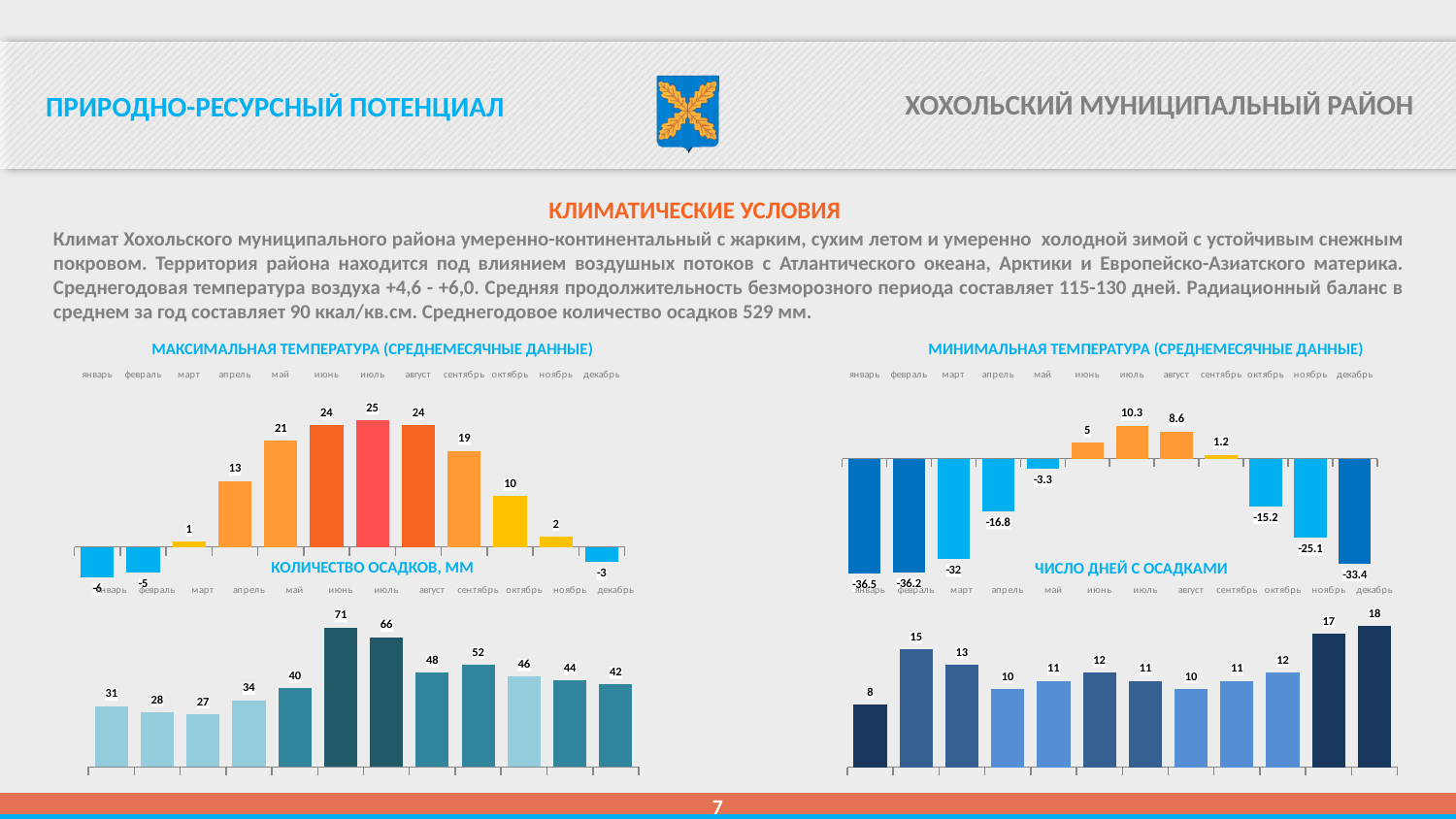
On the chart 'ЧИСЛО ДНЕЙ С ОСАДКАМИ', which is larger, the value for февраль or the value for март? февраль On the chart 'КОЛИЧЕСТВО ОСАДКОВ, ММ', which month has the lowest value? март On the chart 'КОЛИЧЕСТВО ОСАДКОВ, ММ', what is the difference between the values for июнь and июль? 5 What type of chart is 'КОЛИЧЕСТВО ОСАДКОВ, ММ'? bar chart How many months (categories) are shown on the chart 'МАКСИМАЛЬНАЯ ТЕМПЕРАТУРА (СРЕДНЕМЕСЯЧНЫЕ ДАННЫЕ)'? 12 On the chart 'ЧИСЛО ДНЕЙ С ОСАДКАМИ', what is the value for декабрь? 18 On the chart 'МИНИМАЛЬНАЯ ТЕМПЕРАТУРА (СРЕДНЕМЕСЯЧНЫЕ ДАННЫЕ)', what is the value for апрель? -16.8 On the chart 'ЧИСЛО ДНЕЙ С ОСАДКАМИ', which month has the lowest value? январь On the chart 'КОЛИЧЕСТВО ОСАДКОВ, ММ', what is the value for июнь? 71 On the chart 'МАКСИМАЛЬНАЯ ТЕМПЕРАТУРА (СРЕДНЕМЕСЯЧНЫЕ ДАННЫЕ)', which month has the lowest value? январь On the chart 'МАКСИМАЛЬНАЯ ТЕМПЕРАТУРА (СРЕДНЕМЕСЯЧНЫЕ ДАННЫЕ)', what is the value for июль? 25 On the chart 'МИНИМАЛЬНАЯ ТЕМПЕРАТУРА (СРЕДНЕМЕСЯЧНЫЕ ДАННЫЕ)', which month has the highest value? июль